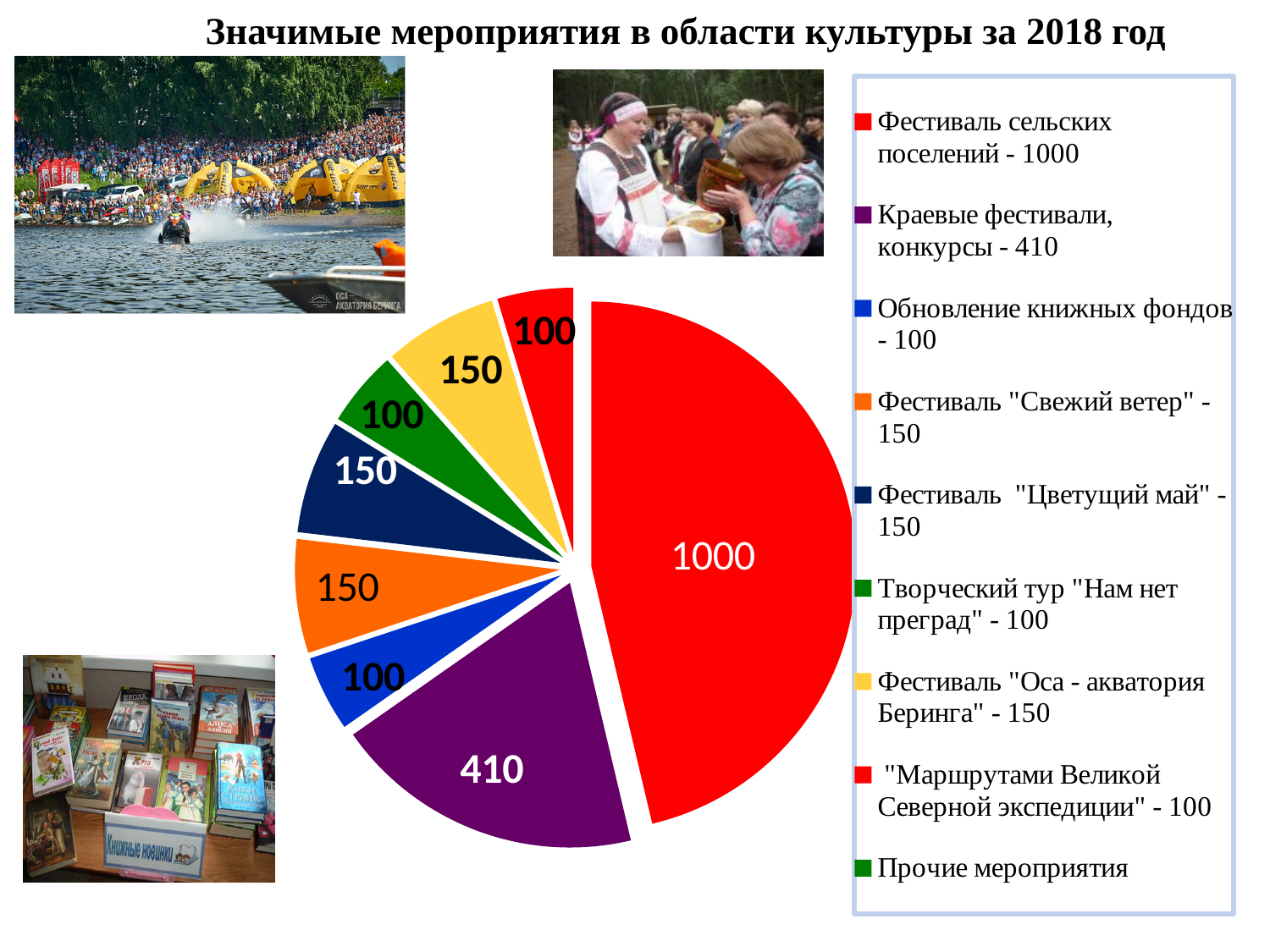
What is the value for "Краевые фестивали, конкурсы"? 410 What is the value for "Фестиваль сельских поселений"? 1000 How many entries does the legend list? 9 Which category has the largest slice of the pie? Фестиваль сельских поселений Which is larger: "Краевые фестивали, конкурсы" or "Фестиваль "Свежий ветер""? Краевые фестивали, конкурсы What is the title of the slide? Значимые мероприятия в области культуры за 2018 год What kind of chart is shown on the slide? pie chart What is the value for "Обновление книжных фондов"? 100 How many slices does the pie chart have? 8 What is the value for "Фестиваль "Оса - акватория Беринга""? 150 What is the difference between the values for "Фестиваль сельских поселений" and "Краевые фестивали, конкурсы"? 590 What is the difference between the values for "Фестиваль "Свежий ветер"" and "Обновление книжных фондов"? 50